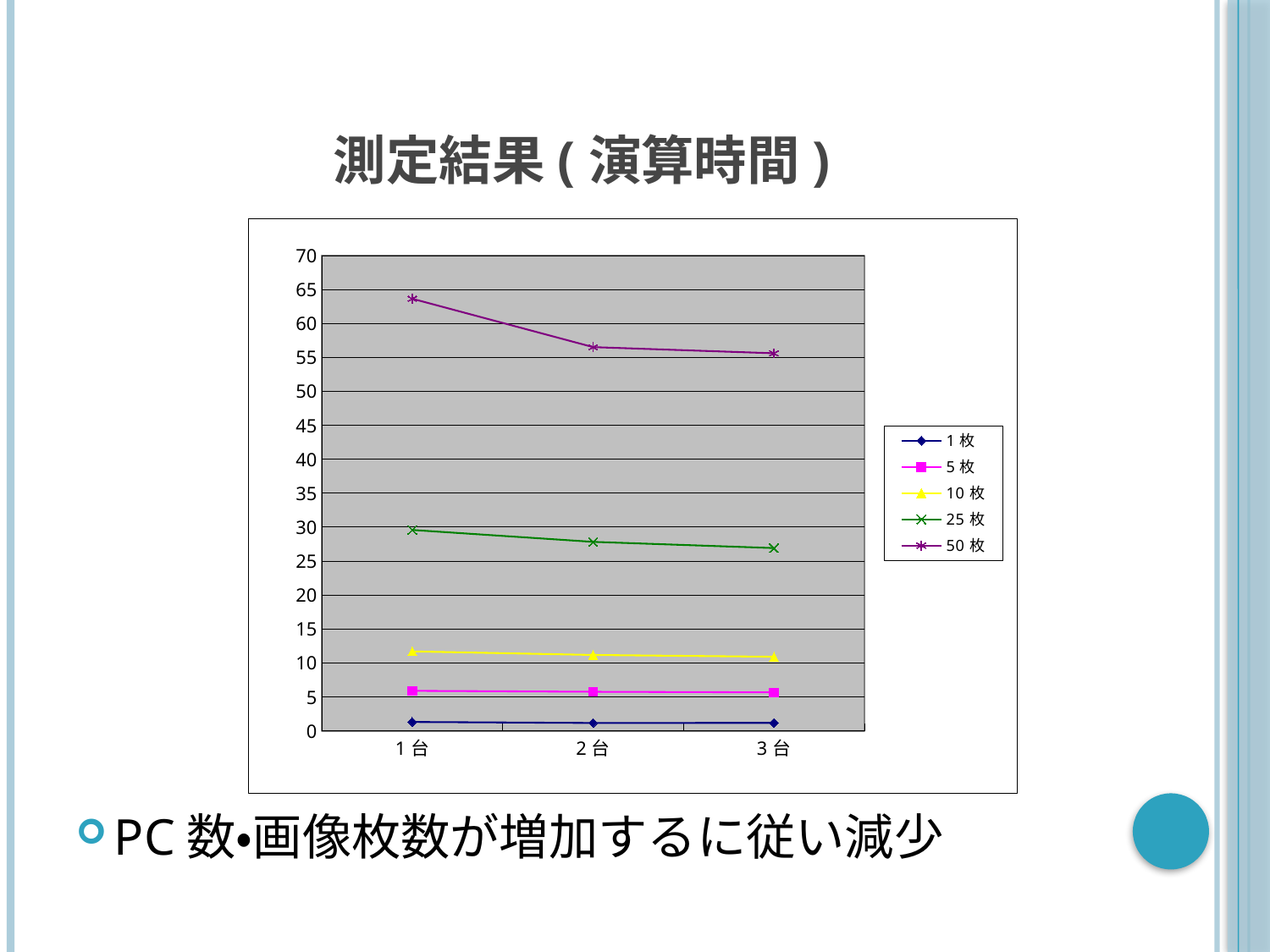
Which series has the highest value at 1台? 50 枚 How many series does the legend list? 5 Is the value for 10 枚 at 2台 greater or less than 15? less Is the value for 50 枚 at 1台 greater or less than 60? greater What kind of chart is shown on the slide? line chart Is the value for 50 枚 at 3台 greater or less than 60? less How many categories are on the x axis? 3 What is the title shown above the chart? 測定結果 ( 演算時間 ) Does the 50 枚 series rise or fall from 1台 to 3台? falls For the 25 枚 series, which is larger: the value at 1台 or at 3台? 1台 Which series has the lowest value at 3台? 1 枚